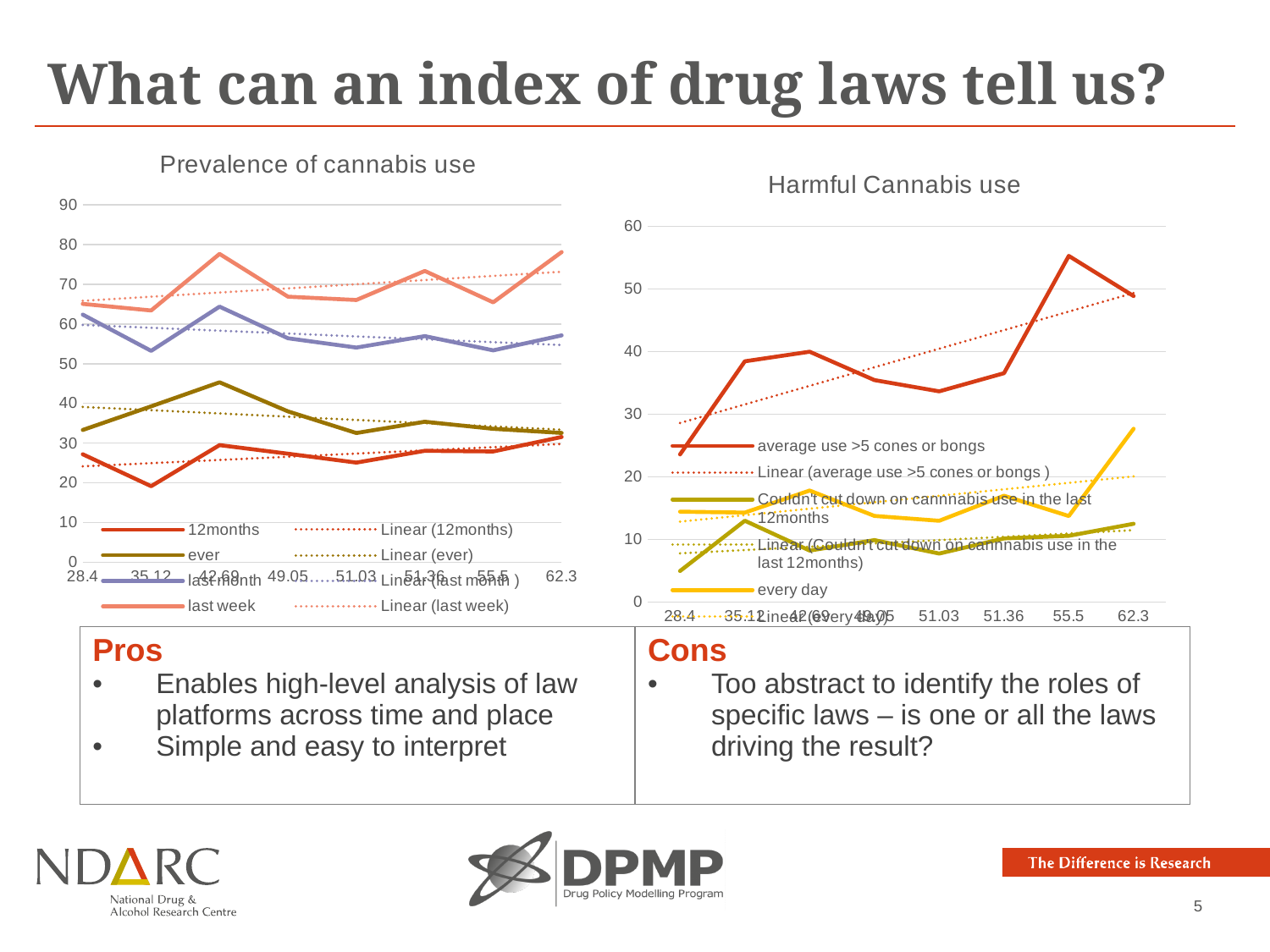
What type of chart is the 'Prevalence of cannabis use' chart? line chart In the 'Harmful Cannabis use' chart, is the value for 'average use >5 cones or bongs' at 55.5 greater or less than 50? greater In the 'Harmful Cannabis use' chart, at 62.3, which is larger: 'average use >5 cones or bongs' or 'every day'? average use >5 cones or bongs In the 'Harmful Cannabis use' chart, is the value for 'Couldn't cut down on cannabis use in the last 12months' at 28.4 greater or less than 10? less In the 'Prevalence of cannabis use' chart, which series has the highest values across the x axis? last week How many entries does the legend of the 'Harmful Cannabis use' chart list? 6 In the 'Prevalence of cannabis use' chart, which series has the lowest values across the x axis? 12months How many entries does the legend of the 'Prevalence of cannabis use' chart list? 8 In the 'Prevalence of cannabis use' chart, does the 'Linear (ever)' trendline rise or fall along the x axis? fall In the 'Prevalence of cannabis use' chart, is the value for 'last week' at 62.3 greater or less than 70? greater How many x-axis points are plotted on the 'Harmful Cannabis use' chart? 8